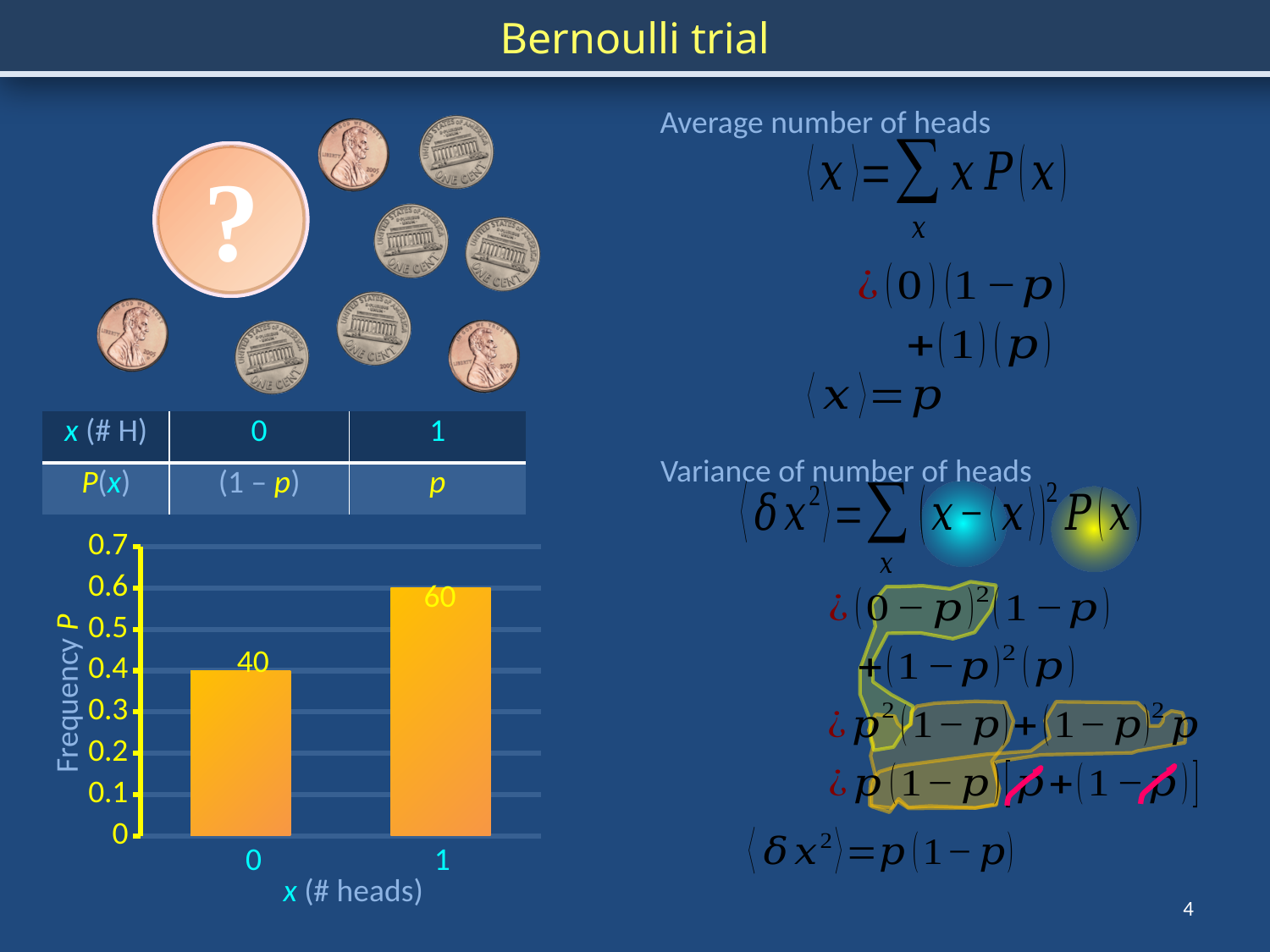
What type of chart is shown on the slide? bar chart Is the value for x = 1 greater or less than 0.5 on the Frequency P axis? greater Is the bar for x = 1 taller or shorter than the bar for x = 0? taller What is the data label on the bar for x = 1 head? 60 Is the value for x = 0 greater or less than 0.5 on the Frequency P axis? less What is the difference between the data labels of the bars for x = 1 and x = 0? 20 How many bars (categories) does the chart show? 2 What is the label of the vertical axis of the chart? Frequency P What is the data label on the bar for x = 0 heads? 40 Which value of x (# heads) has the shorter bar? 0 Which value of x (# heads) has the taller bar? 1 What is the label of the horizontal axis of the chart? x (# heads)